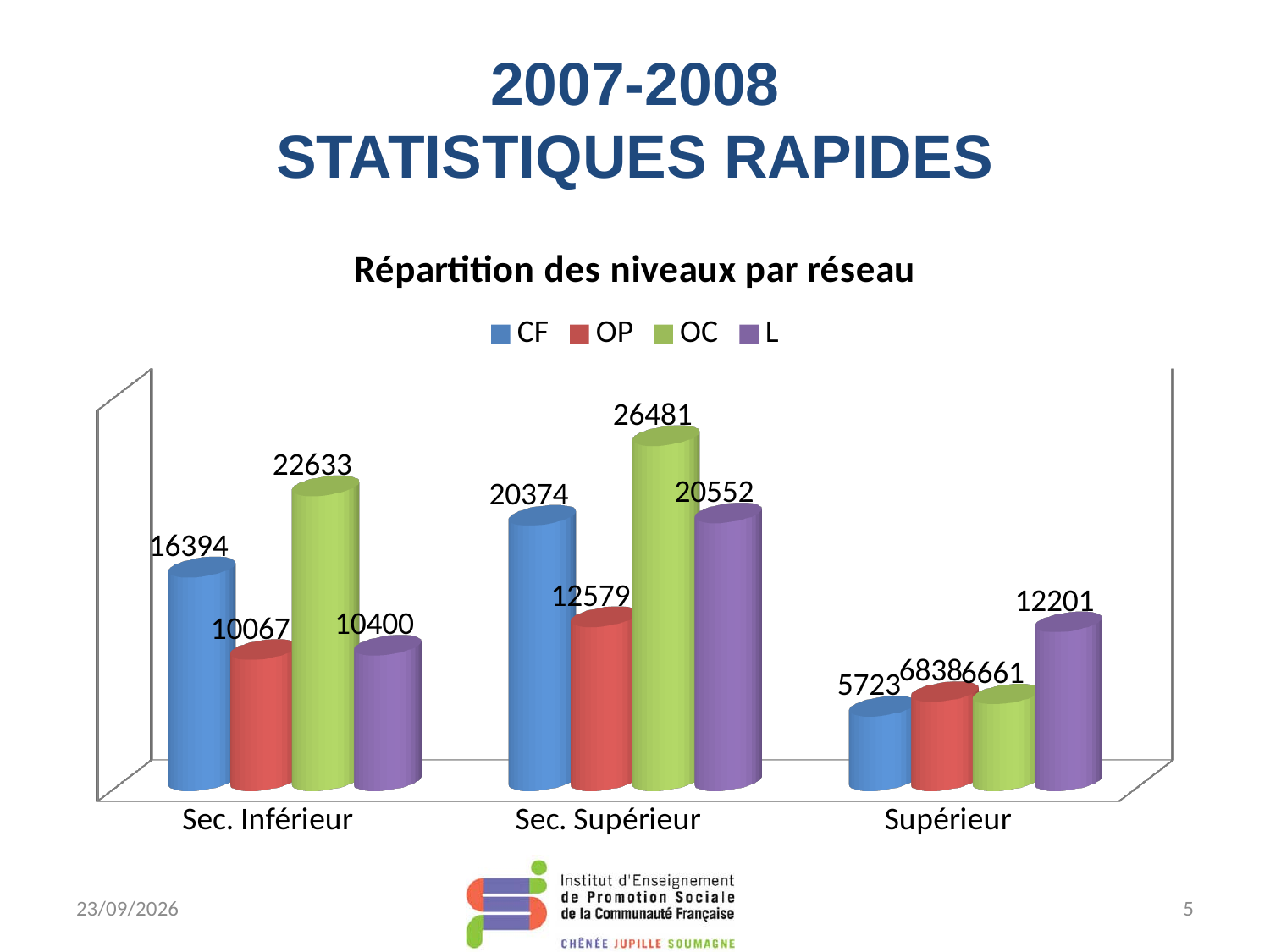
What type of chart is shown on the slide? Bar chart What is the difference between the OC and CF values in the Sec. Supérieur category? 6107 What is the value for CF in the Sec. Inférieur category? 16394 How many series does the legend list? 4 Which series has the lowest value in the Supérieur category? CF What is the value for OP in the Sec. Supérieur category? 12579 How many categories are shown on the x axis? 3 What is the value for OC in the Sec. Supérieur category? 26481 Which is larger in the Sec. Inférieur category, the value for OP or the value for L? L Which series has the highest value in the Sec. Inférieur category? OC What is the value for L in the Supérieur category? 12201 What is the difference between the L values for Sec. Supérieur and Sec. Inférieur? 10152